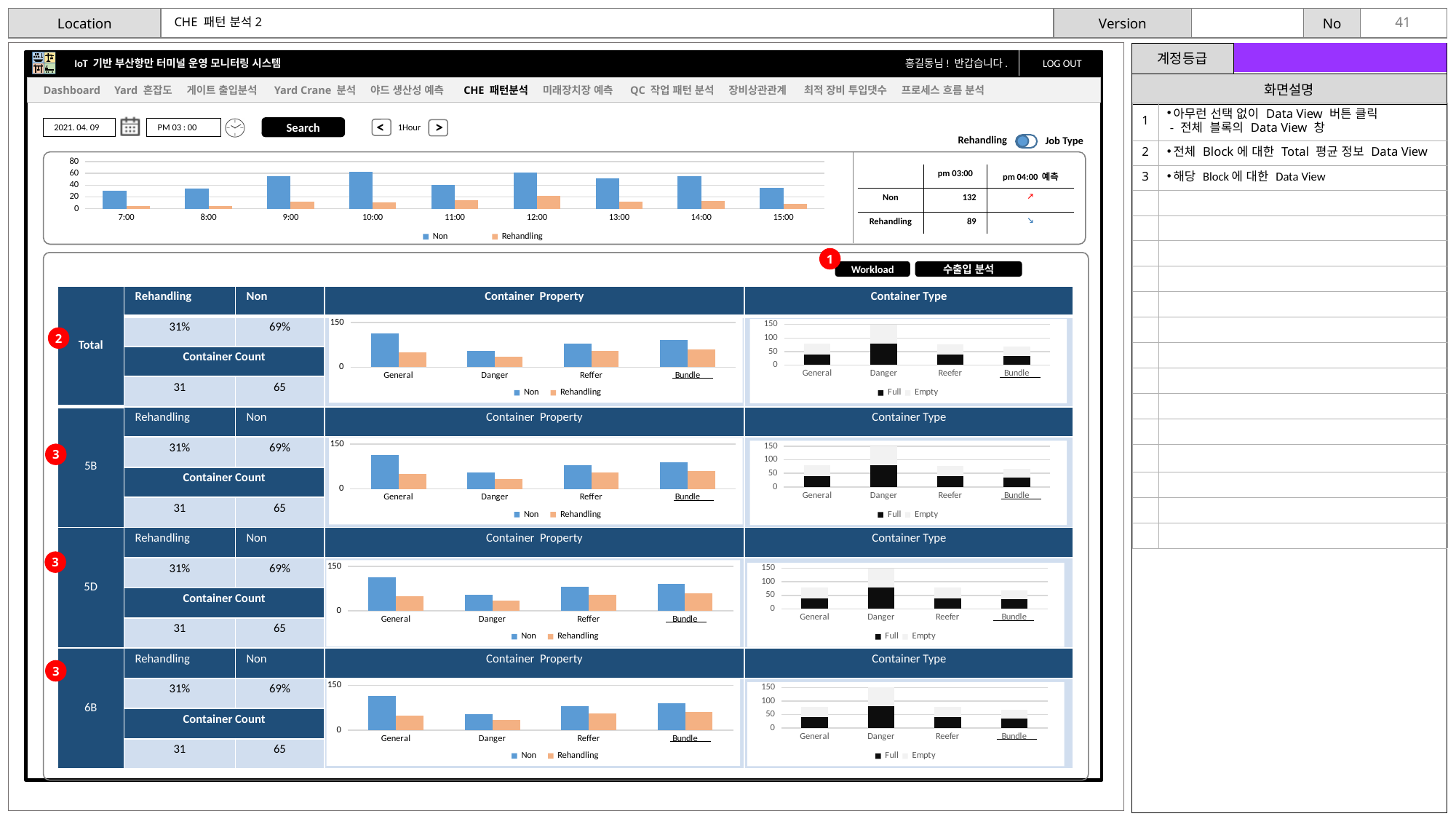
In the Total row's Container Property chart, which category has the lowest Non value? Danger How many series does the legend of the top hourly chart list? 2 What are the two legend entries of the Container Type charts? Full, Empty In the top hourly chart, at which hour is the Rehandling value highest? 12:00 In the Total row's Container Property chart, which category has the highest Non value? General How many hourly categories are shown on the x axis of the top hourly chart? 9 In the Total row's Container Type chart, which category has the highest Full value? Danger In the top hourly chart, is the Non value at 7:00 greater or less than 40? less In the top hourly chart, which is larger at 12:00, Non or Rehandling? Non In the top hourly chart, is the Non value at 10:00 greater or less than 40? greater In the Total row's Container Type chart, is the Full value for Danger greater or less than 50? greater What kind of chart is the hourly chart at the top of the dashboard? bar chart